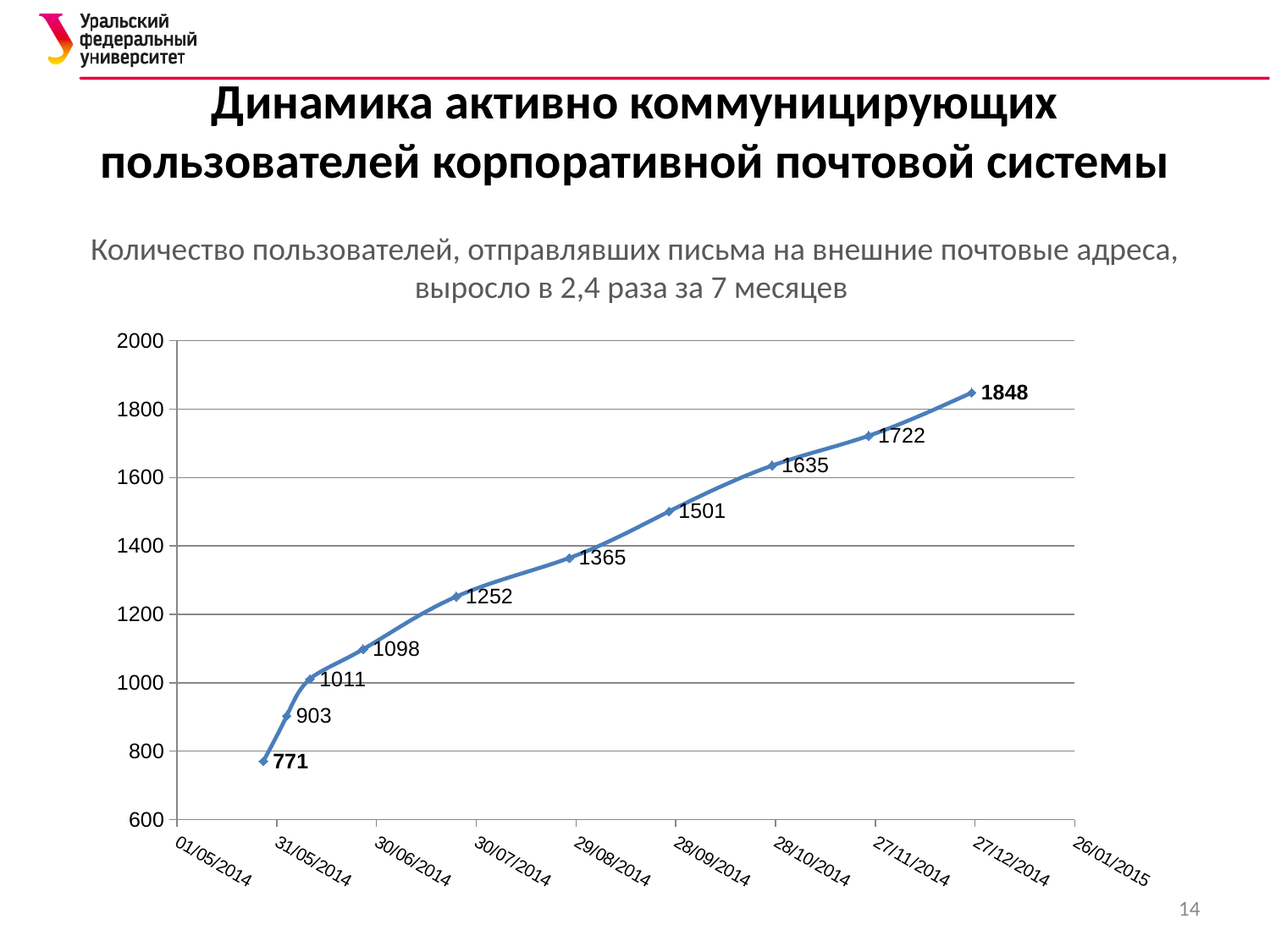
What is the value of the fifth data point from the left? 1252 What is the value of the first (leftmost) data point on the line? 771 What is the difference between the last data point (1848) and the first data point (771)? 1077 Do the values rise or fall from left to right along the x axis? rise What is the value of the last (rightmost) data point on the line? 1848 How many data points are plotted on the line? 10 Which is larger, the data point labelled 1722 or the one labelled 1635? 1722 What is the lowest value labelled on the line? 771 What kind of chart is shown on the slide? line chart Is the value of the second data point (903) greater or less than 1000? less What is the difference between the data points labelled 1501 and 1365? 136 What is the highest value labelled on the line? 1848